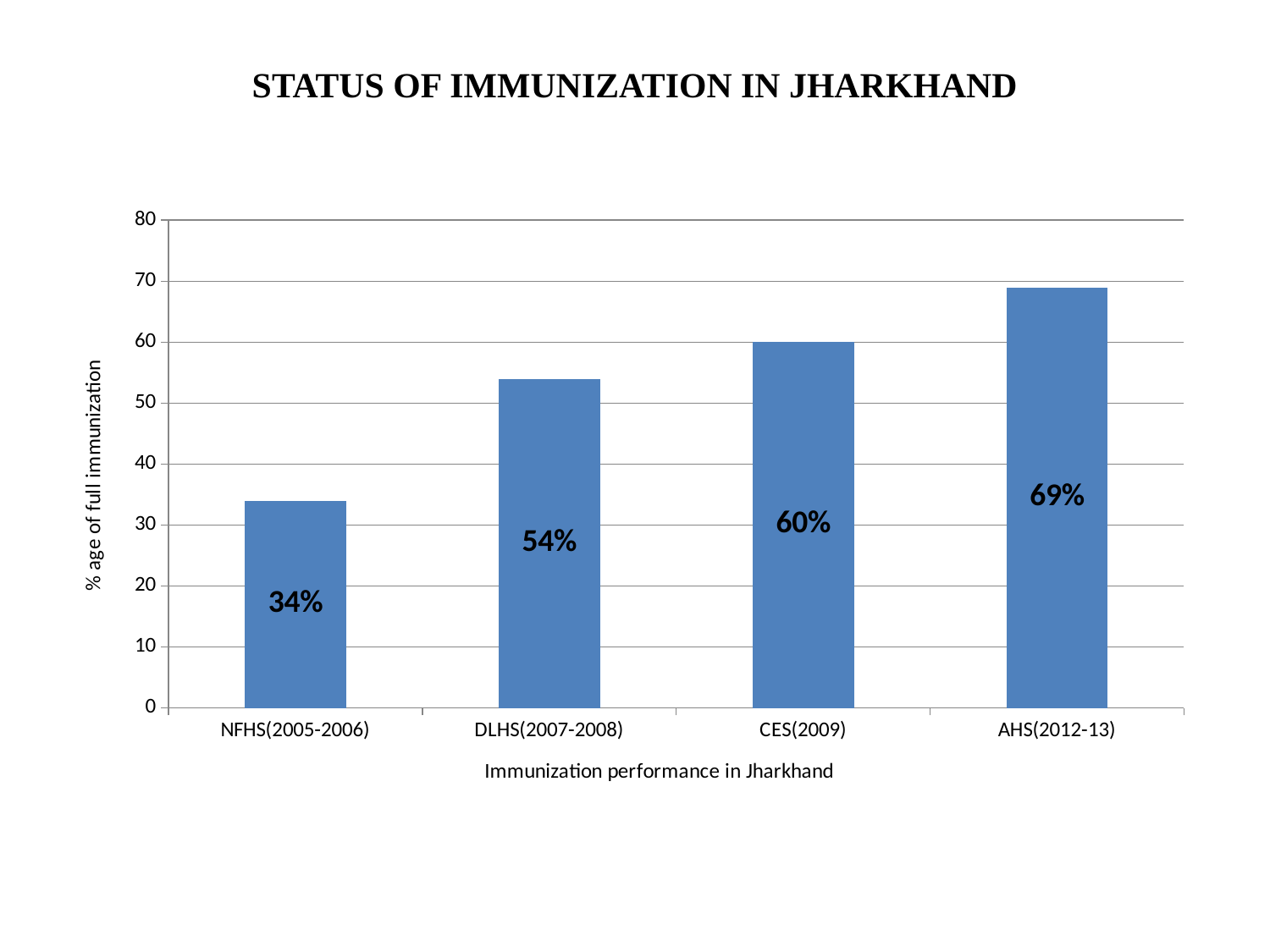
What is the value for AHS(2012-13)? 69% What kind of chart is shown on the slide? Bar chart Which category has the highest value? AHS(2012-13) Do the values rise or fall from left to right along the x axis? Rise What is the value for CES(2009)? 60% What is the value for DLHS(2007-2008)? 54% Is the value for DLHS(2007-2008) greater or less than 50? greater Which is larger, the value for CES(2009) or the value for DLHS(2007-2008)? CES(2009) What is the difference between the values for AHS(2012-13) and NFHS(2005-2006)? 35% What is the value for NFHS(2005-2006)? 34% Which category has the lowest value? NFHS(2005-2006) How many categories are shown on the x axis? 4